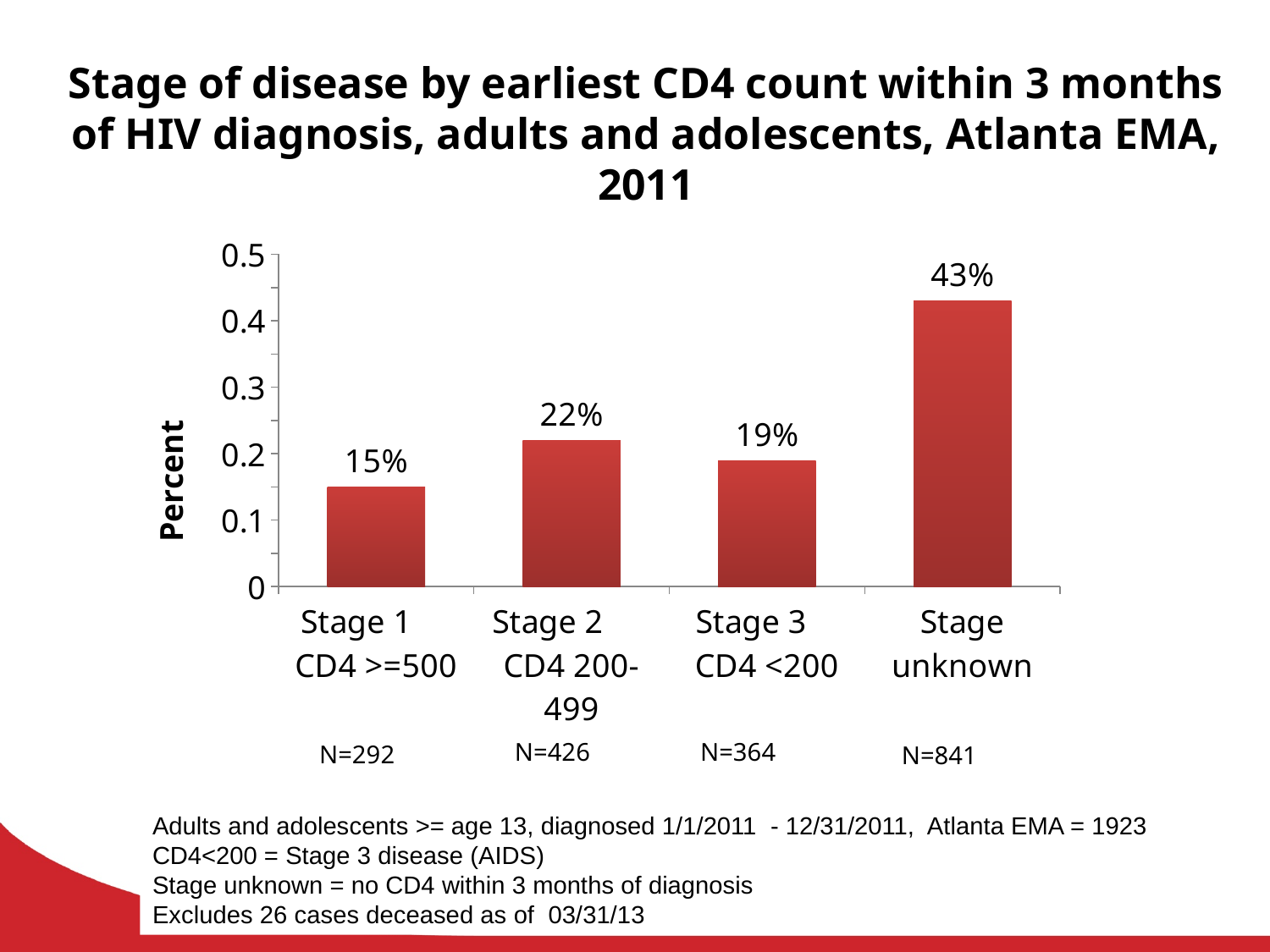
What is the label of the y axis? Percent What is the difference in percent between Stage unknown and Stage 2 CD4 200-499? 21% Is the value for Stage unknown greater or less than 0.4? greater What percent is shown for Stage 2 CD4 200-499? 22% What percent is shown for Stage unknown? 43% What percent is shown for Stage 1 CD4 >=500? 15% What kind of chart is shown on the slide? Bar chart Which is larger, the percent for Stage 2 CD4 200-499 or Stage 3 CD4 <200? Stage 2 CD4 200-499 Which category has the highest percent? Stage unknown Which category has the lowest percent? Stage 1 CD4 >=500 How many categories are shown on the x axis? 4 What percent is shown for Stage 3 CD4 <200? 19%